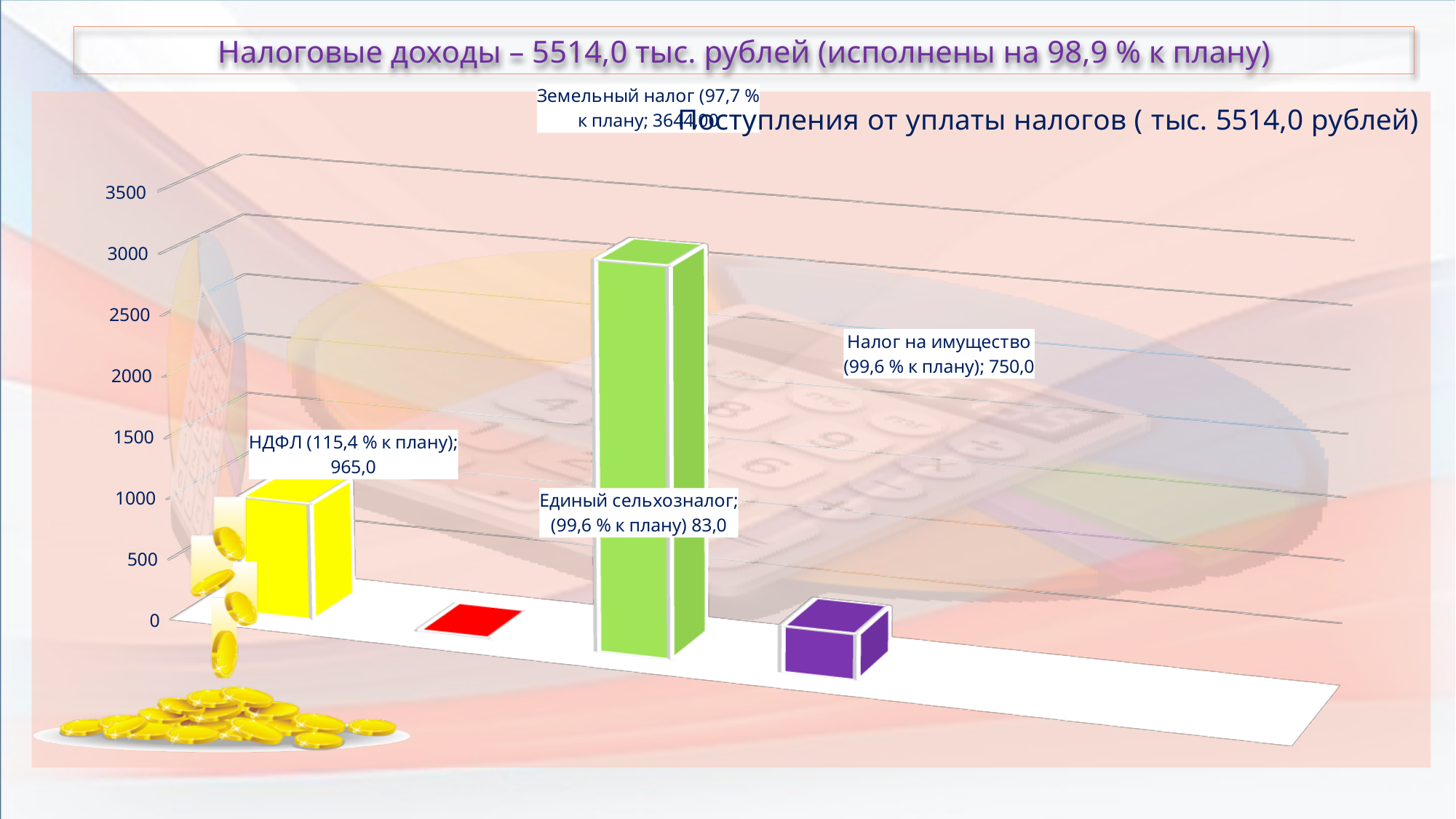
Which tax has the lowest bar? Единый сельхозналог Which is larger, the value for НДФЛ or the value for Налог на имущество? НДФЛ Is the value for Единый сельхозналог greater or less than 500? less Is the value for Земельный налог greater or less than 2500? greater What is the value for Единый сельхозналог? 83,0 What is the value for Налог на имущество? 750,0 How many taxes (bars) are shown in the chart? 4 What is the difference between the values for НДФЛ and Налог на имущество? 215,0 What percentage of the plan was achieved for НДФЛ according to its data label? 115,4 % What is the value for НДФЛ? 965,0 What kind of chart is shown on the slide? bar chart Which tax has the highest bar? Земельный налог